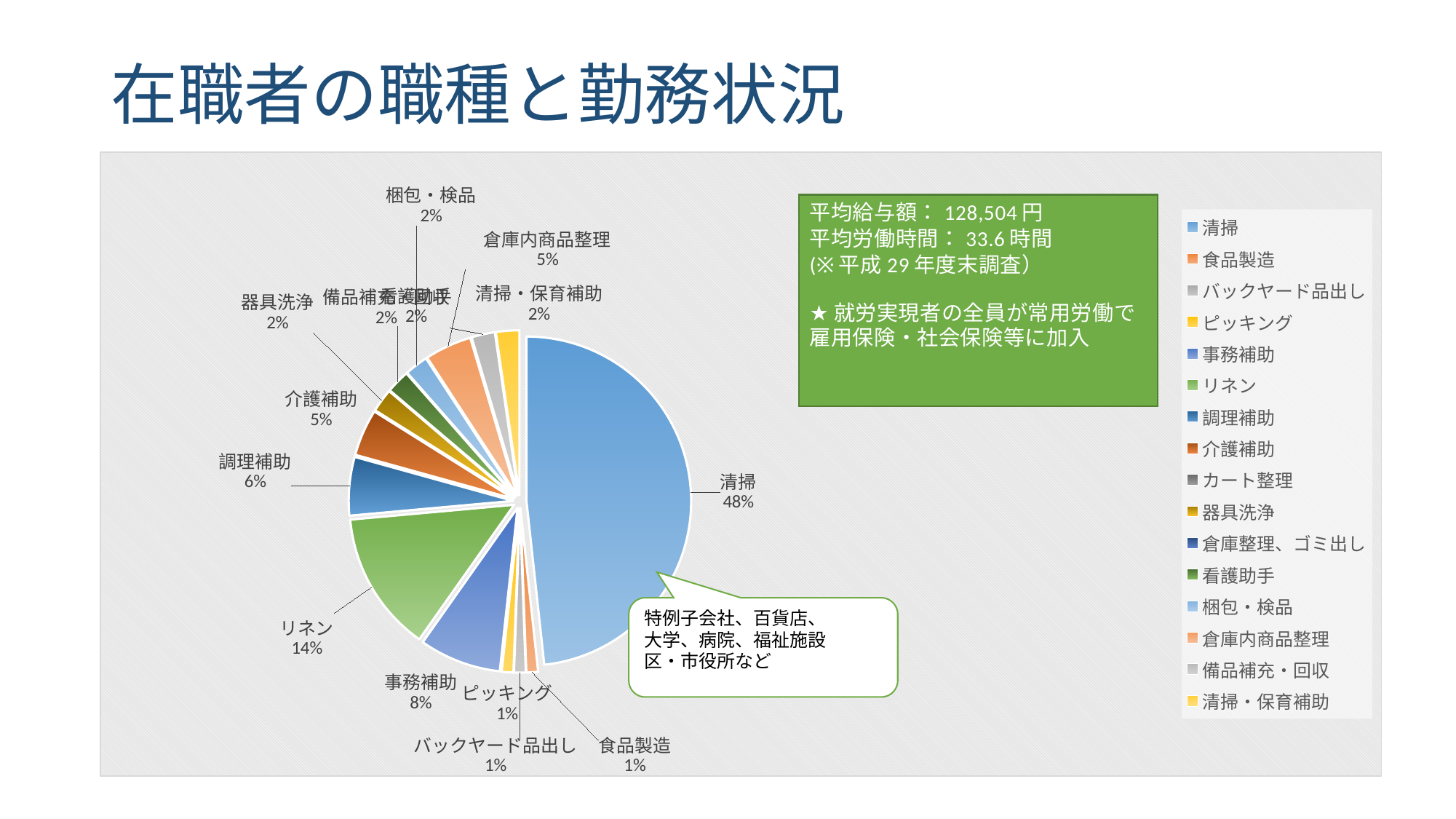
What is the value shown for ピッキング in the pie chart? 1% What is the value shown for 梱包・検品 in the pie chart? 2% What kind of chart is shown on the slide? Pie chart Which category has the largest slice of the pie chart? 清掃 What is the value shown for 倉庫内商品整理 in the pie chart? 5% What is the value shown for リネン in the pie chart? 14% What is the value shown for 事務補助 in the pie chart? 8% Which is larger in the pie chart, 事務補助 or 調理補助? 事務補助 What is the difference in percentage points between 清掃 and リネン? 34 percentage points How many entries does the legend of the pie chart list? 16 What is the value shown for 調理補助 in the pie chart? 6% What share of the pie does 清掃 account for? 48%